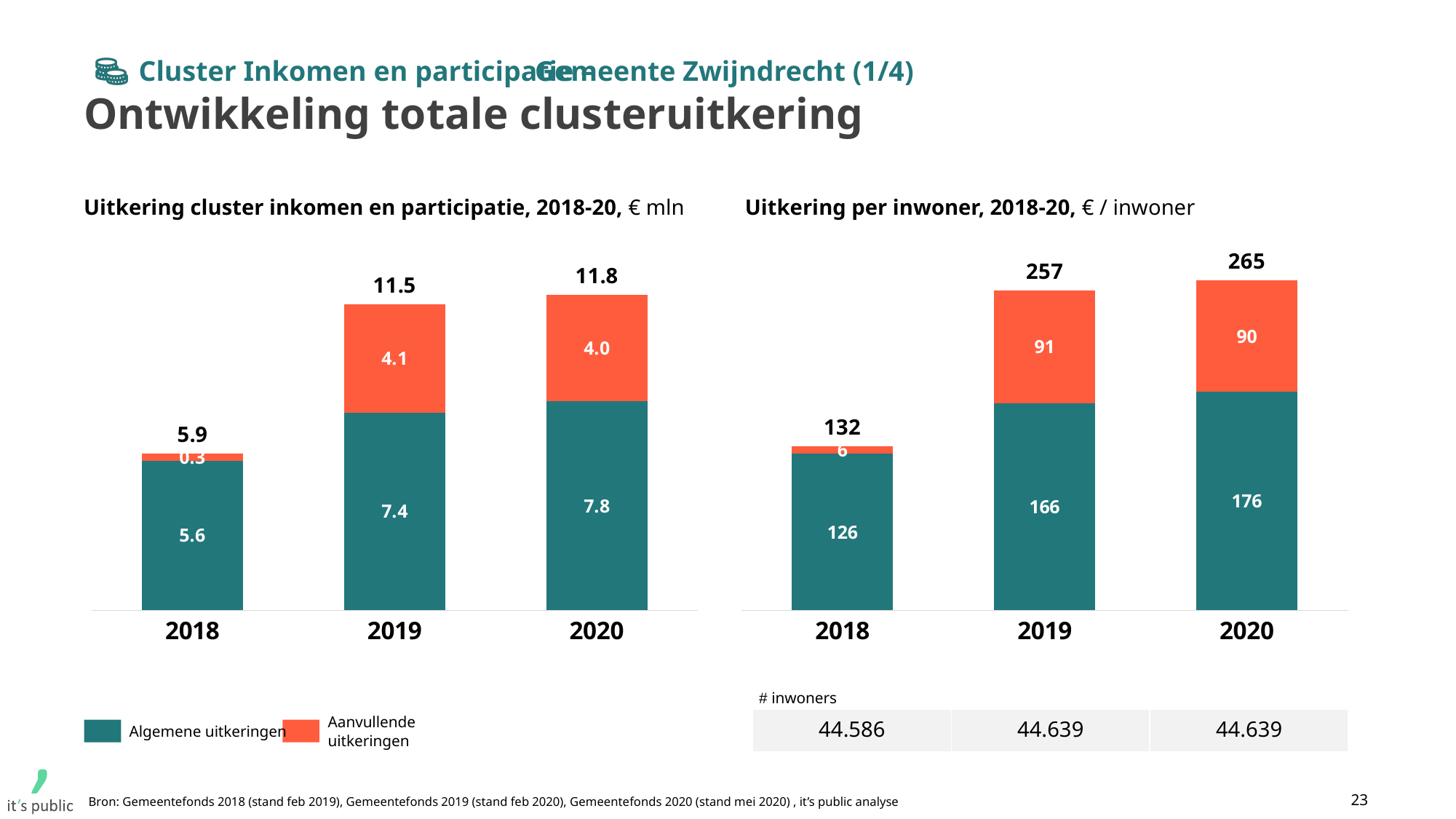
In the left chart (Uitkering cluster inkomen en participatie), which year has the highest total? 2020 What kind of chart is the left chart (Uitkering cluster inkomen en participatie)? Stacked bar chart In the right chart (Uitkering per inwoner), what is the value of Algemene uitkeringen for 2020? 176 In the right chart (Uitkering per inwoner), what is the value of Aanvullende uitkeringen for 2019? 91 In the right chart (Uitkering per inwoner), what is the total of the stacked bar for 2020? 265 In the right chart (Uitkering per inwoner), which year has the lowest total? 2018 In the left chart (Uitkering cluster inkomen en participatie), what is the value of Algemene uitkeringen for 2019? 7.4 In the right chart (Uitkering per inwoner), is the Algemene uitkeringen value larger for 2019 or for 2020? 2020 In the left chart (Uitkering cluster inkomen en participatie), what is the difference between the Aanvullende uitkeringen values for 2019 and 2018? 3.8 In the left chart (Uitkering cluster inkomen en participatie), what is the total of the stacked bar for 2018? 5.9 How many series does the legend list for the left chart? 2 In the left chart (Uitkering cluster inkomen en participatie), what is the value of Aanvullende uitkeringen for 2020? 4.0